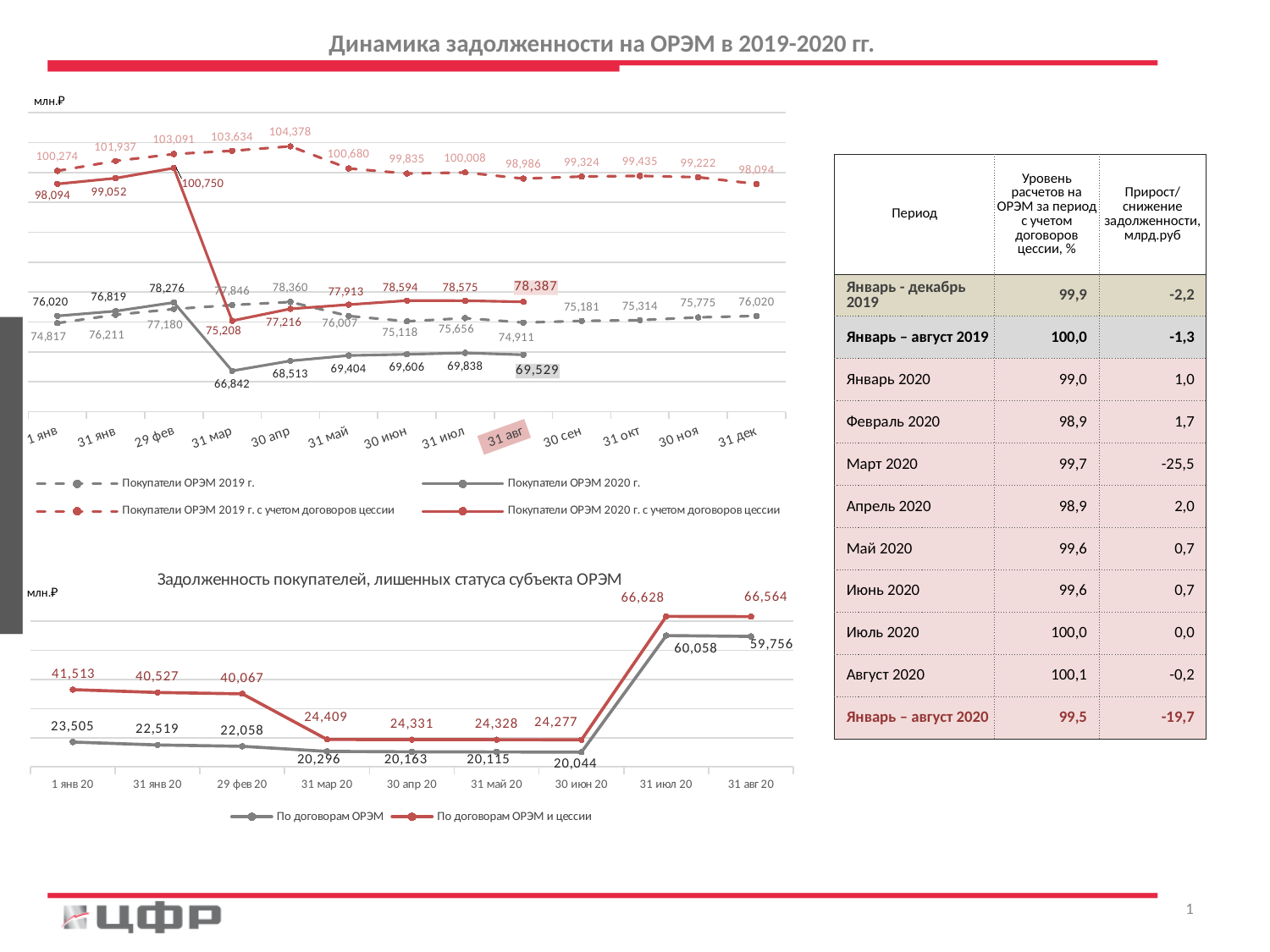
In the bottom chart 'Задолженность покупателей, лишенных статуса субъекта ОРЭМ', what is the difference between 'По договорам ОРЭМ и цессии' and 'По договорам ОРЭМ' on 31 июл 20? 6,570 What type of chart is the bottom chart 'Задолженность покупателей, лишенных статуса субъекта ОРЭМ'? Line chart In the bottom chart 'Задолженность покупателей, лишенных статуса субъекта ОРЭМ', at which date is the 'По договорам ОРЭМ и цессии' series highest? 31 июл 20 In the top chart, what is the value for 'Покупатели ОРЭМ 2019 г. с учетом договоров цессии' on 30 апр? 104,378 In the top chart, which is larger on 31 мар: 'Покупатели ОРЭМ 2019 г.' or 'Покупатели ОРЭМ 2020 г.'? Покупатели ОРЭМ 2019 г. How many dates are plotted on the x axis of the bottom chart 'Задолженность покупателей, лишенных статуса субъекта ОРЭМ'? 9 In the top chart, what is the value for 'Покупатели ОРЭМ 2020 г. с учетом договоров цессии' on 31 авг? 78,387 In the bottom chart 'Задолженность покупателей, лишенных статуса субъекта ОРЭМ', at which date is the 'По договорам ОРЭМ' series lowest? 30 июн 20 In the bottom chart 'Задолженность покупателей, лишенных статуса субъекта ОРЭМ', what is the value for 'По договорам ОРЭМ' on 1 янв 20? 23,505 In the top chart, what is the difference between 'Покупатели ОРЭМ 2020 г.' on 29 фев and on 31 мар? 11,434 In the bottom chart 'Задолженность покупателей, лишенных статуса субъекта ОРЭМ', what is the value for 'По договорам ОРЭМ и цессии' on 31 авг 20? 66,564 How many series does the legend of the top chart list? 4